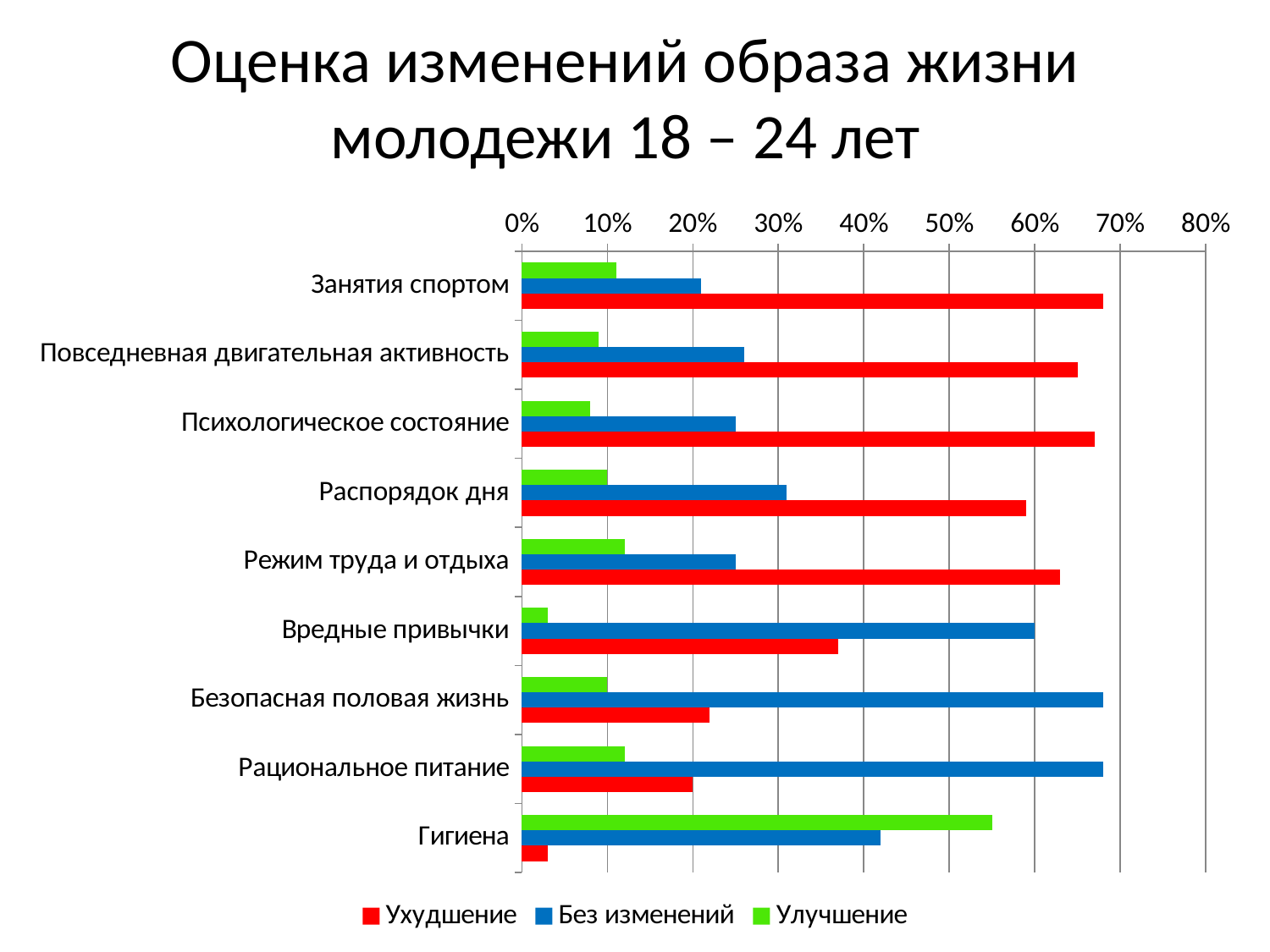
Which category has the highest Улучшение value? Гигиена Which category has the lowest Ухудшение value? Гигиена Is the Улучшение value for Гигиена greater or less than 50%? greater Which series does the legend list first? Ухудшение For Вредные привычки, which is larger: Ухудшение or Без изменений? Без изменений How many series does the legend list? 3 Is the Ухудшение value for Занятия спортом greater or less than 60%? greater Is the Ухудшение value for Рациональное питание greater or less than 30%? less For Гигиена, which is larger: Улучшение or Ухудшение? Улучшение How many categories are listed on the vertical axis of the chart? 9 What kind of chart is shown on the slide? bar chart